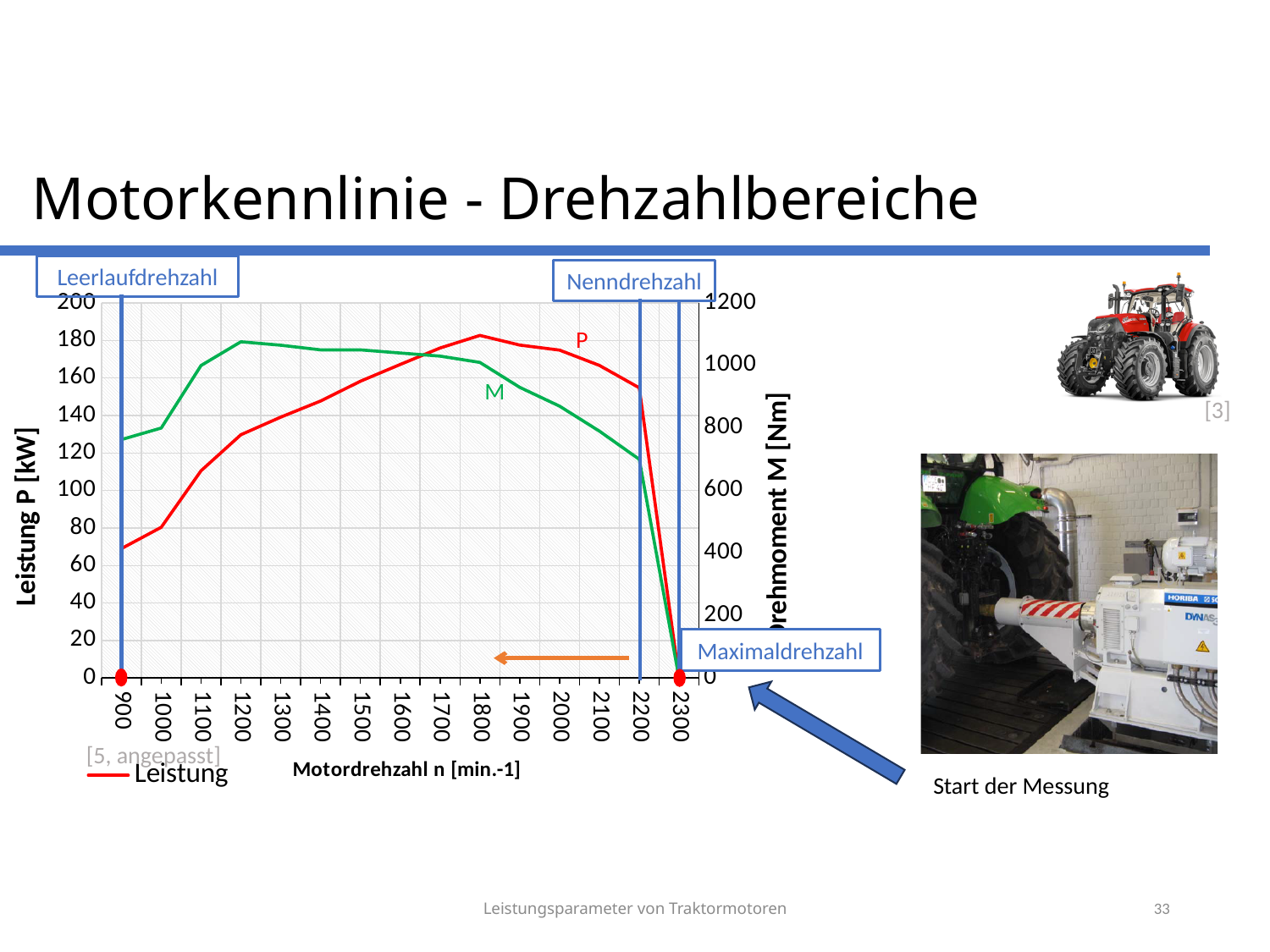
At which engine speed on the x axis is the Nenndrehzahl marked? 2200 Is the Leistung (P) value at 1800 min-1 greater or less than 160 kW? greater At which engine speed does the Leistung (P) line reach its highest value? 1800 Does the Leistung (P) line rise or fall between 900 and 1800 min-1? rise What kind of chart is shown on the slide? line chart At which engine speed on the x axis is the Maximaldrehzahl marked? 2300 What is the title of the x axis of the chart? Motordrehzahl n [min.-1] What is the title of the left y axis of the chart? Leistung P [kW] Is the Drehmoment (M) value at 1200 min-1 greater or less than 1000 Nm? greater Is the Drehmoment (M) value at 900 min-1 greater or less than 600 Nm? greater At which engine speed on the x axis is the Leerlaufdrehzahl marked? 900